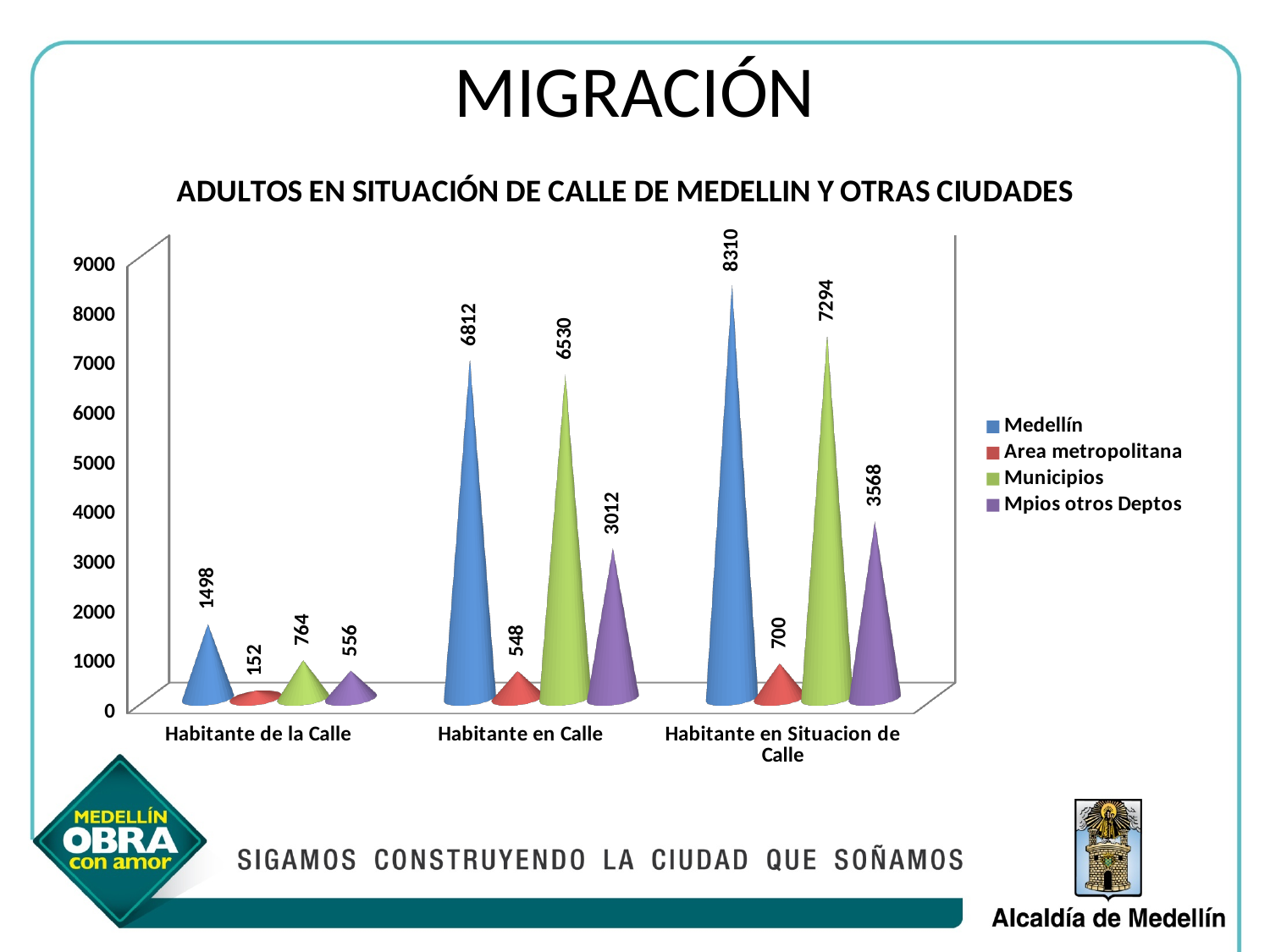
Which is larger: the Municipios value for Habitante de la Calle or the Mpios otros Deptos value for Habitante de la Calle? Municipios How many categories are shown on the x axis? 3 What is the value for Mpios otros Deptos in the Habitante en Situacion de Calle category? 3568 What is the value for Medellín in the Habitante en Situacion de Calle category? 8310 What is the value for Area metropolitana in the Habitante de la Calle category? 152 Which series has the highest value in the Habitante en Calle category? Medellín What is the value for Municipios in the Habitante en Calle category? 6530 How many series does the legend list? 4 What is the title of the chart? ADULTOS EN SITUACIÓN DE CALLE DE MEDELLIN Y OTRAS CIUDADES What kind of chart is shown on the slide? Bar chart What is the difference between the Medellín and Municipios values in the Habitante en Situacion de Calle category? 1016 Which series has the lowest value in the Habitante de la Calle category? Area metropolitana